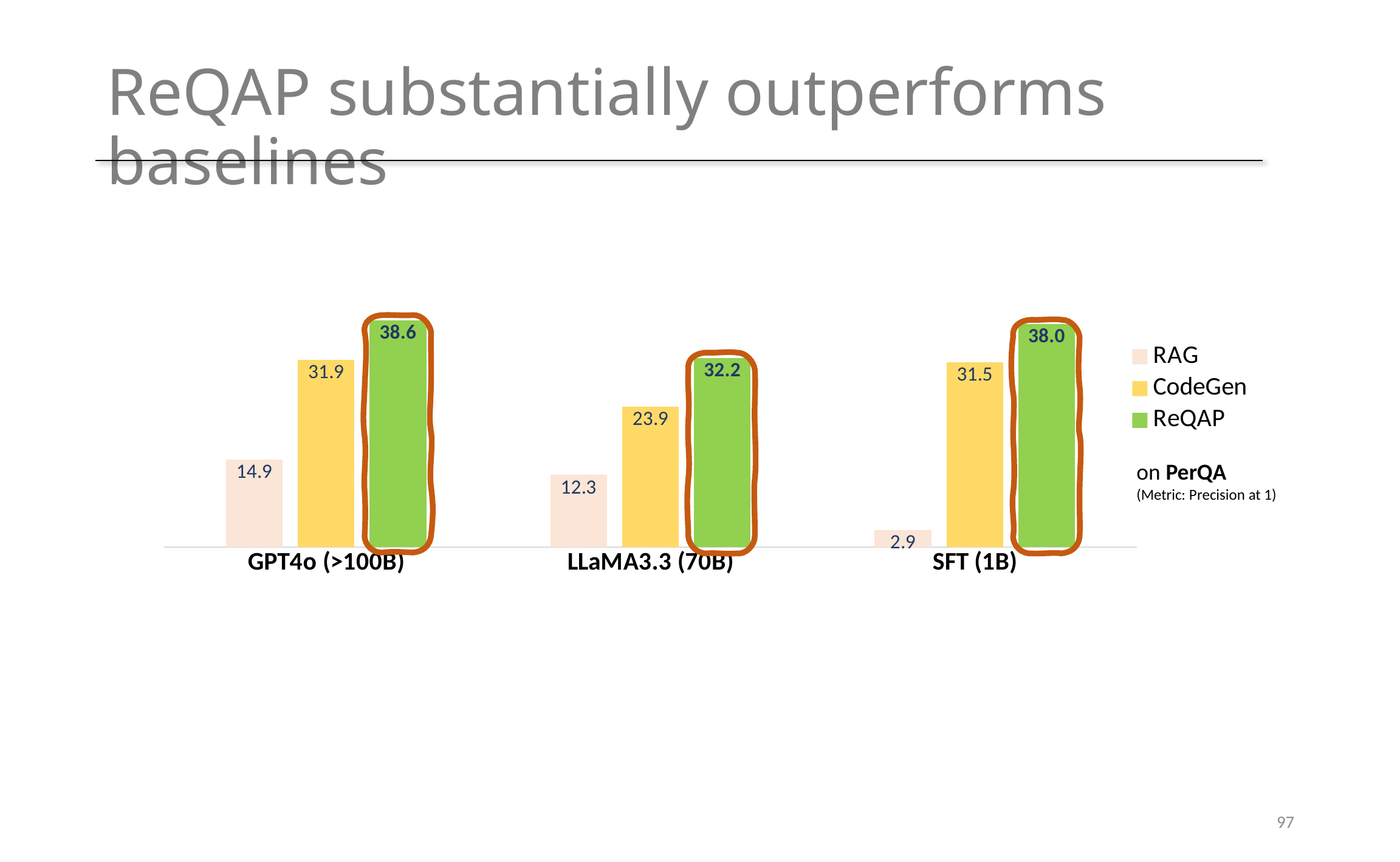
What is the difference between the ReQAP and CodeGen values on SFT (1B)? 6.5 What is the difference between the ReQAP and RAG values on GPT4o (>100B)? 23.7 What is the value for ReQAP on GPT4o (>100B)? 38.6 Which model category has the highest ReQAP value? GPT4o (>100B) What is the value for CodeGen on LLaMA3.3 (70B)? 23.9 What kind of chart is shown on the slide? Bar chart Which model category has the lowest RAG value? SFT (1B) How many model categories are shown on the x axis? 3 What is the value for RAG on SFT (1B)? 2.9 Which is larger on LLaMA3.3 (70B): the CodeGen value or the ReQAP value? ReQAP What is the value for RAG on LLaMA3.3 (70B)? 12.3 How many series does the legend list? 3